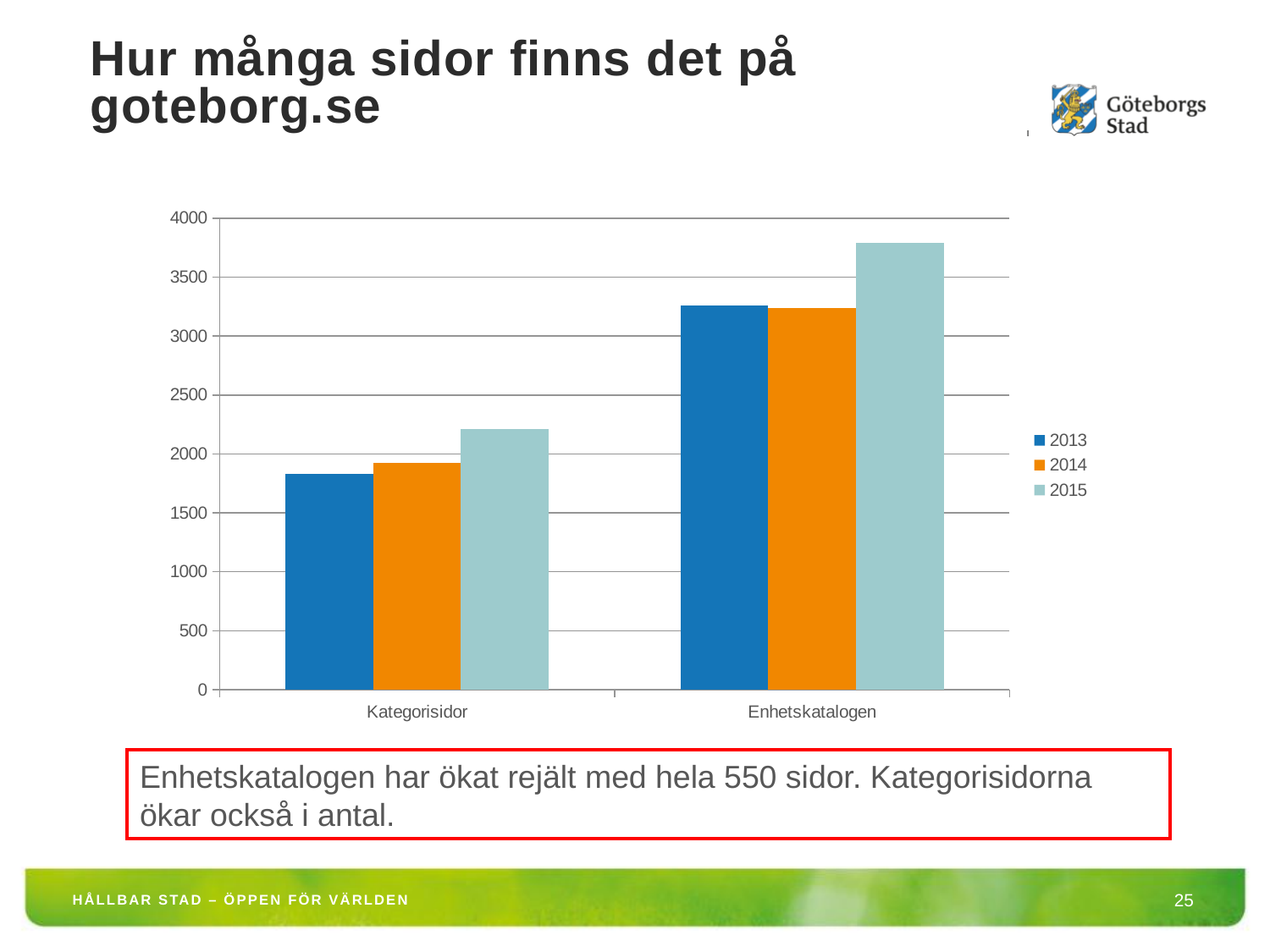
Which is larger for Kategorisidor: the 2015 value or the 2013 value? 2015 Which is larger: Enhetskatalogen in 2015 or Kategorisidor in 2015? Enhetskatalogen in 2015 How many series does the legend list? 3 Which legend entry is shown in orange? 2014 Which category has the highest bar for 2015? Enhetskatalogen How many categories are shown on the x axis? 2 Is the value for Enhetskatalogen in 2014 greater or less than 3000? greater What kind of chart is shown on the slide? bar chart Is the value for Kategorisidor in 2013 greater or less than 2000? less Is the value for Enhetskatalogen in 2015 greater or less than 3500? greater Which category has the lowest bar for 2013? Kategorisidor